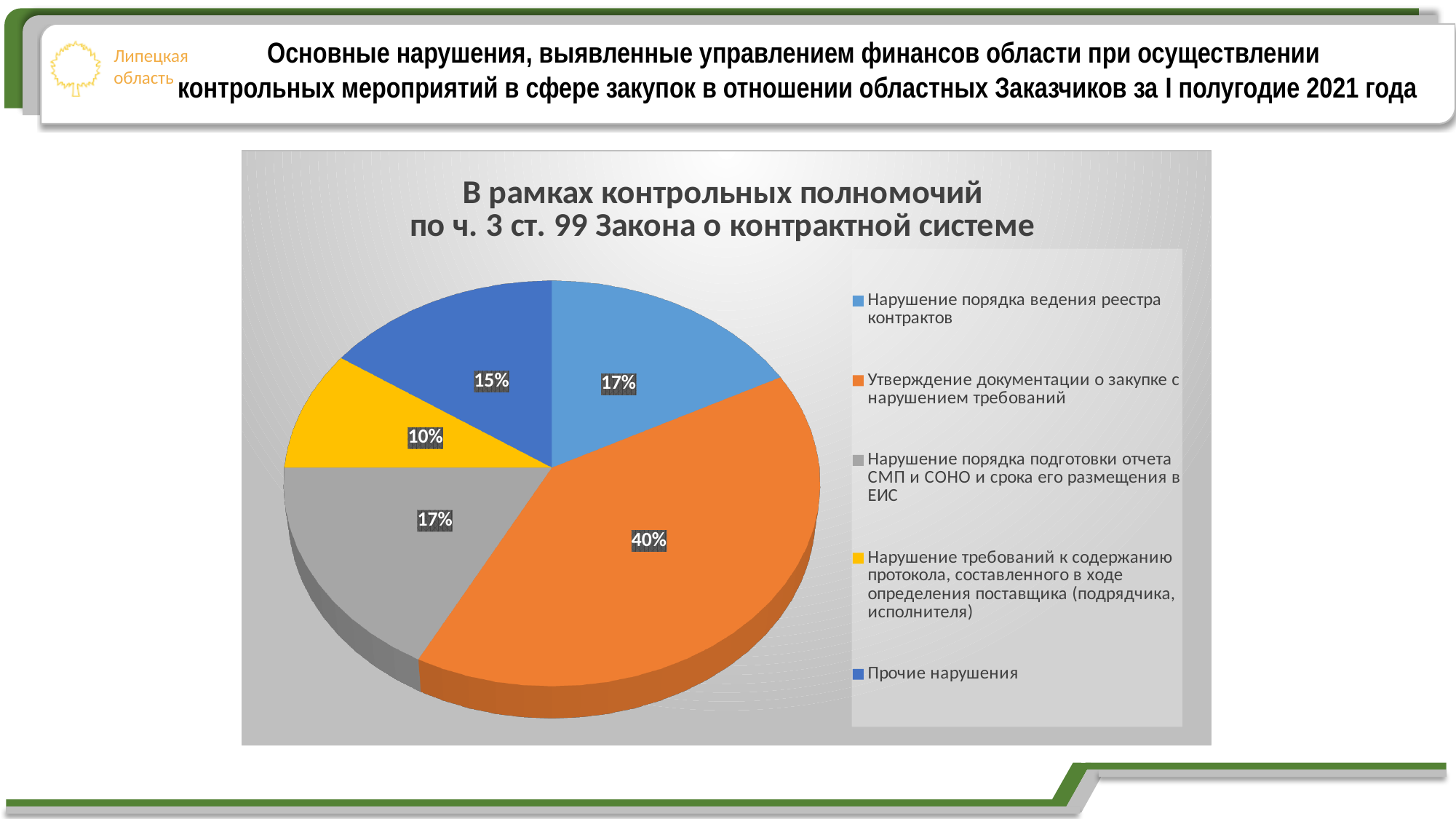
What is the title of the chart? В рамках контрольных полномочий по ч. 3 ст. 99 Закона о контрактной системе How many slices does the pie chart have? 5 What share of the pie does "Нарушение порядка ведения реестра контрактов" account for? 17% Which category has the largest slice of the pie? Утверждение документации о закупке с нарушением требований By how many percentage points does the largest slice exceed the smallest slice? 30 percentage points What share of the pie does "Нарушение требований к содержанию протокола, составленного в ходе определения поставщика (подрядчика, исполнителя)" account for? 10% What share of the pie does "Утверждение документации о закупке с нарушением требований" account for? 40% Which is larger: the share for "Прочие нарушения" or the share for "Нарушение требований к содержанию протокола, составленного в ходе определения поставщика (подрядчика, исполнителя)"? Прочие нарушения What kind of chart is shown on the slide? Pie chart What colour is the slice for "Нарушение порядка подготовки отчета СМП и СОНО и срока его размещения в ЕИС"? Gray Which category has the smallest slice of the pie? Нарушение требований к содержанию протокола, составленного в ходе определения поставщика (подрядчика, исполнителя)